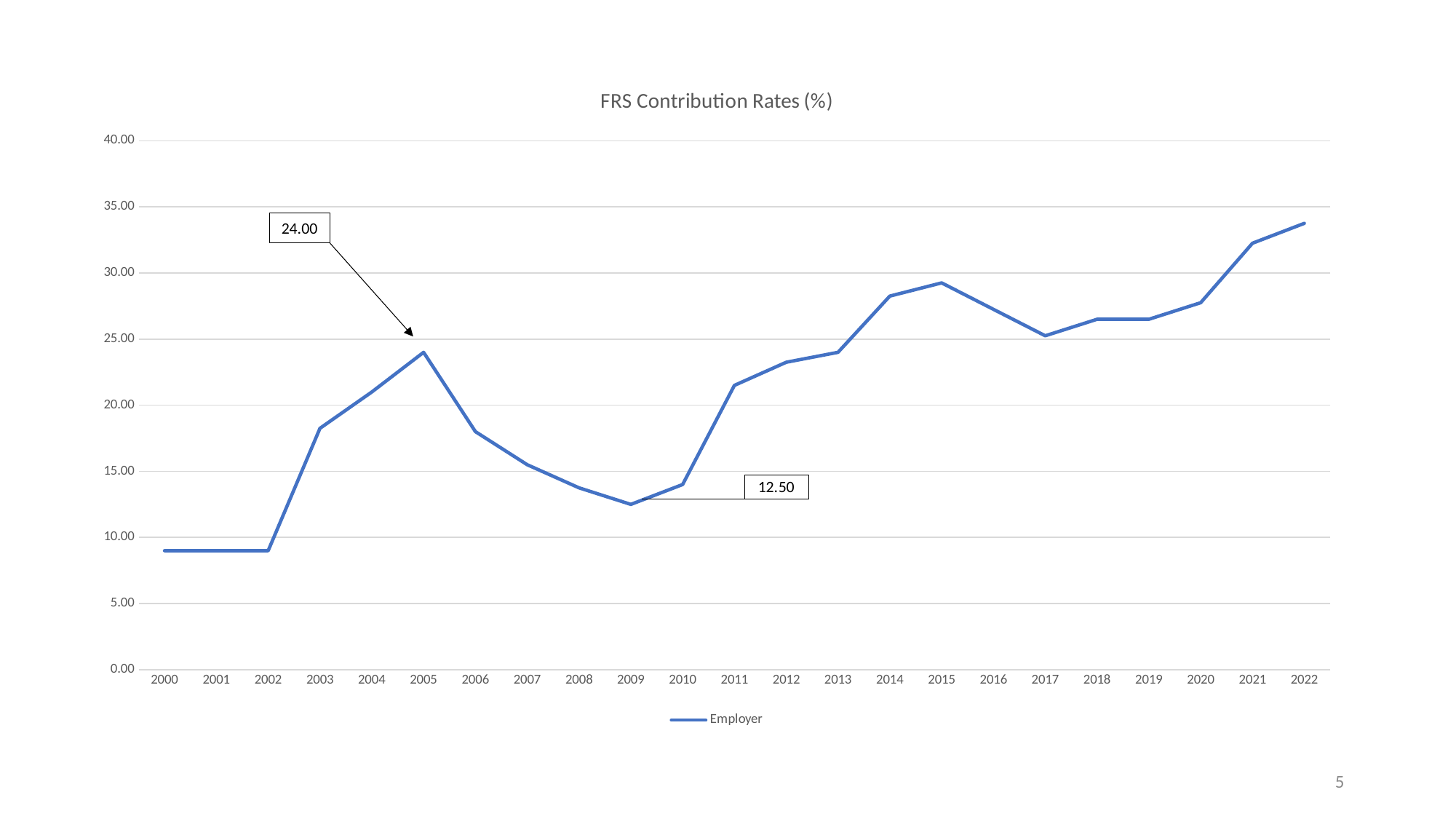
Is the value for 2000 greater or less than 10.00? less Which year has the highest Employer contribution rate? 2022 What kind of chart is shown on the slide? line chart How many years are plotted along the x axis? 23 What is the difference between the labelled values for 2005 and 2009? 11.50 Is the value for 2021 greater or less than 30.00? greater How many series does the legend list? 1 What is the name of the series shown in the legend? Employer What is the Employer contribution rate labelled for 2005? 24.00 Do the values rise or fall from 2005 to 2009? fall What is the Employer contribution rate labelled for 2009? 12.50 What is the title of the chart? FRS Contribution Rates (%)